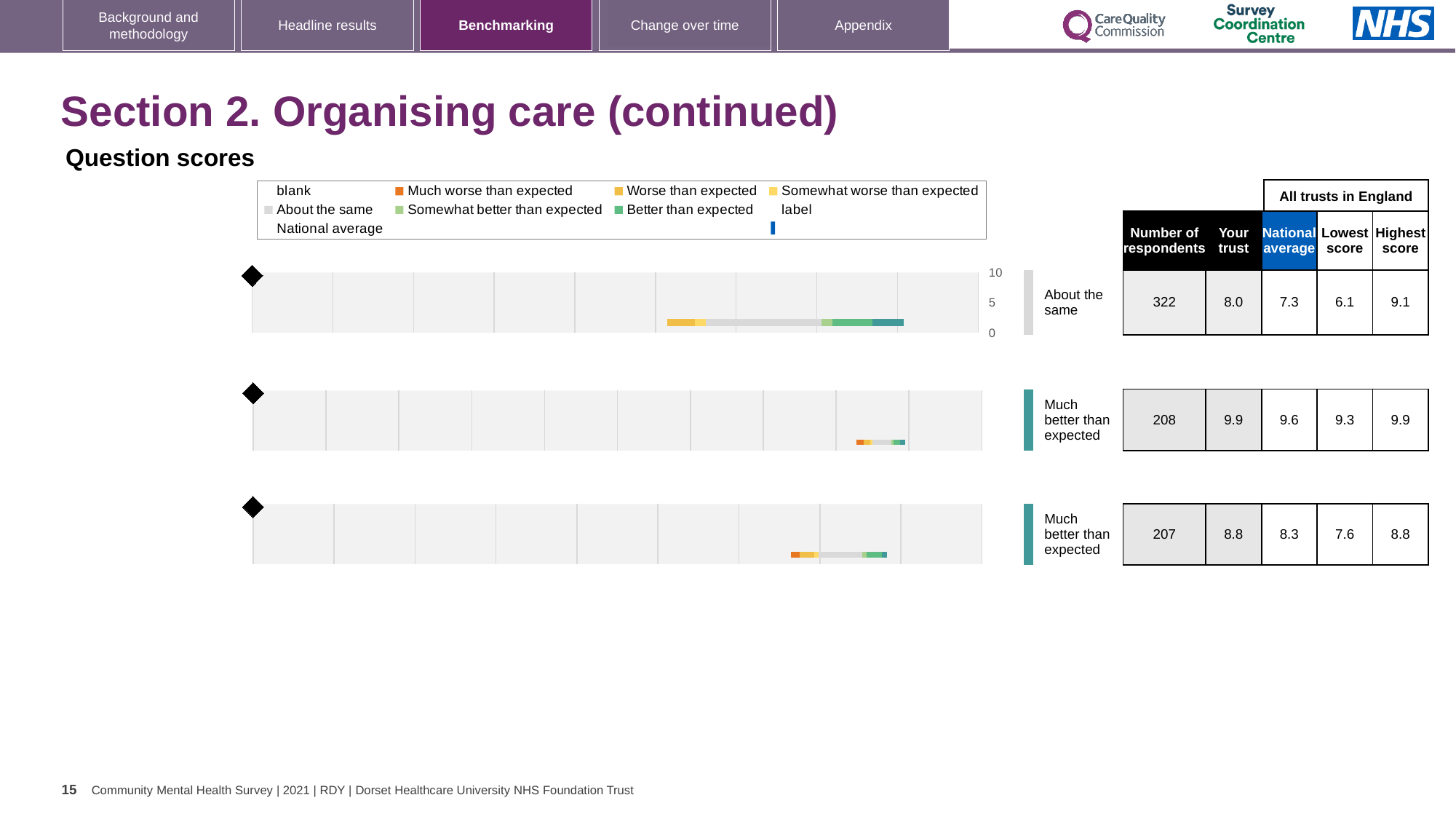
For the top chart, what is the number of respondents? 322 What is the highest value shown on the vertical axis of the top chart? 10 For the top chart, what is the national average score? 7.3 For the top chart, which is larger: the 'Your trust' score or the national average? Your trust For the middle chart, what is the 'Your trust' score? 9.9 What kind of chart is used on this slide to show the question scores? Bar chart Which of the three charts has the highest 'Your trust' score? The middle chart (9.9) For the top chart, what is the 'Your trust' score shown in the table? 8.0 In the legend, what colour represents 'Much worse than expected'? Orange How many question score charts are shown on the slide? 3 For the bottom chart, what is the highest score across all trusts in England? 8.8 For the top chart, what is the difference between the 'Your trust' score and the national average? 0.7